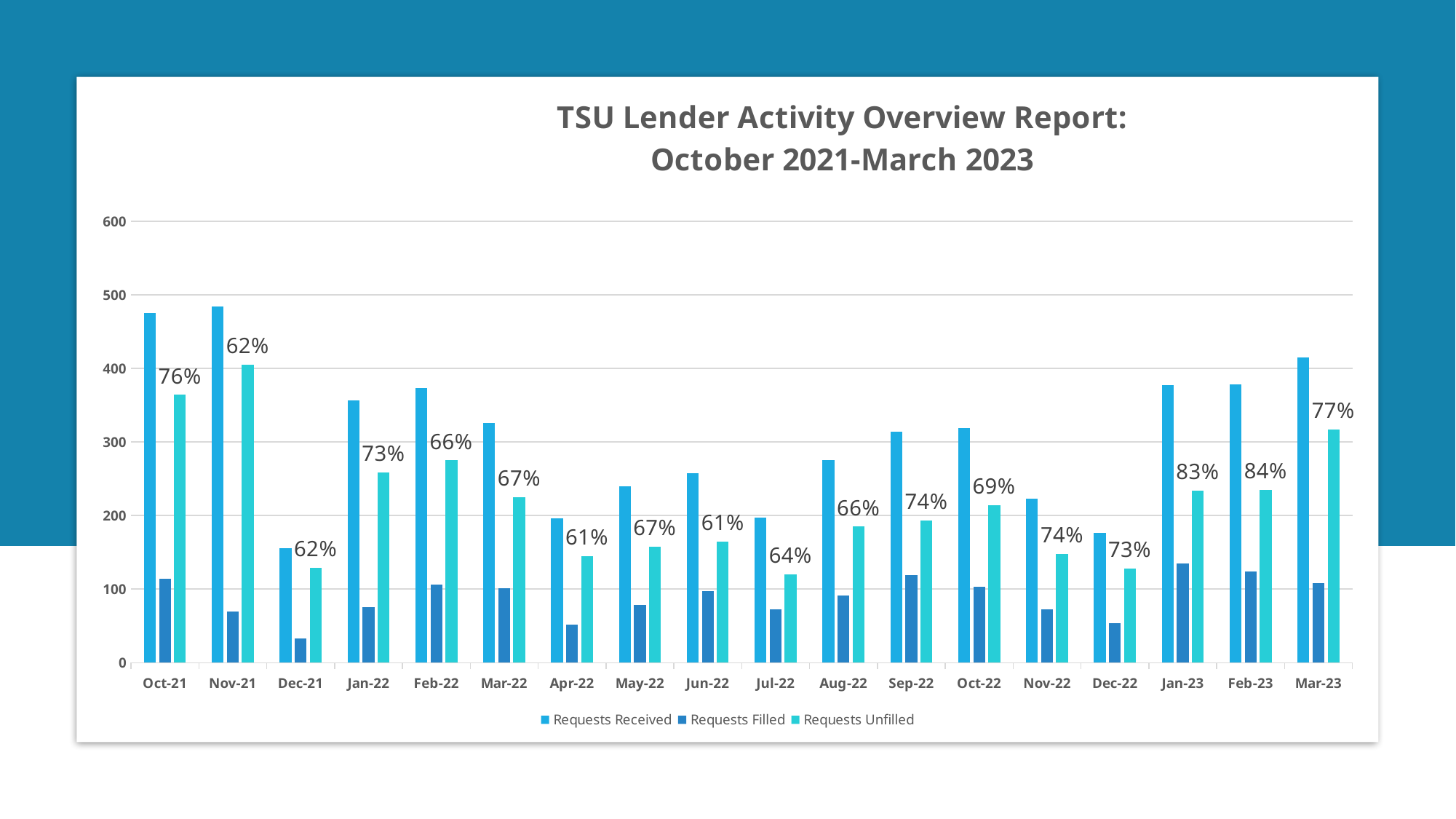
What percentage label is shown for Oct-21? 76% How many series does the legend list? 3 What percentage label is shown for Dec-21? 62% What kind of chart is shown on the slide? bar chart What is the title of the chart? TSU Lender Activity Overview Report: October 2021-March 2023 Which month has the highest percentage label? Feb-23 How many months are shown along the x axis? 18 What percentage label is shown for Jan-23? 83% Which month has the larger Requests Received bar, Oct-21 or Apr-22? Oct-21 Is the Requests Received value for Mar-23 greater or less than 400? greater Which month has the lowest Requests Received bar? Dec-21 What is the difference between the percentage labels for Feb-23 and Nov-21? 22 percentage points